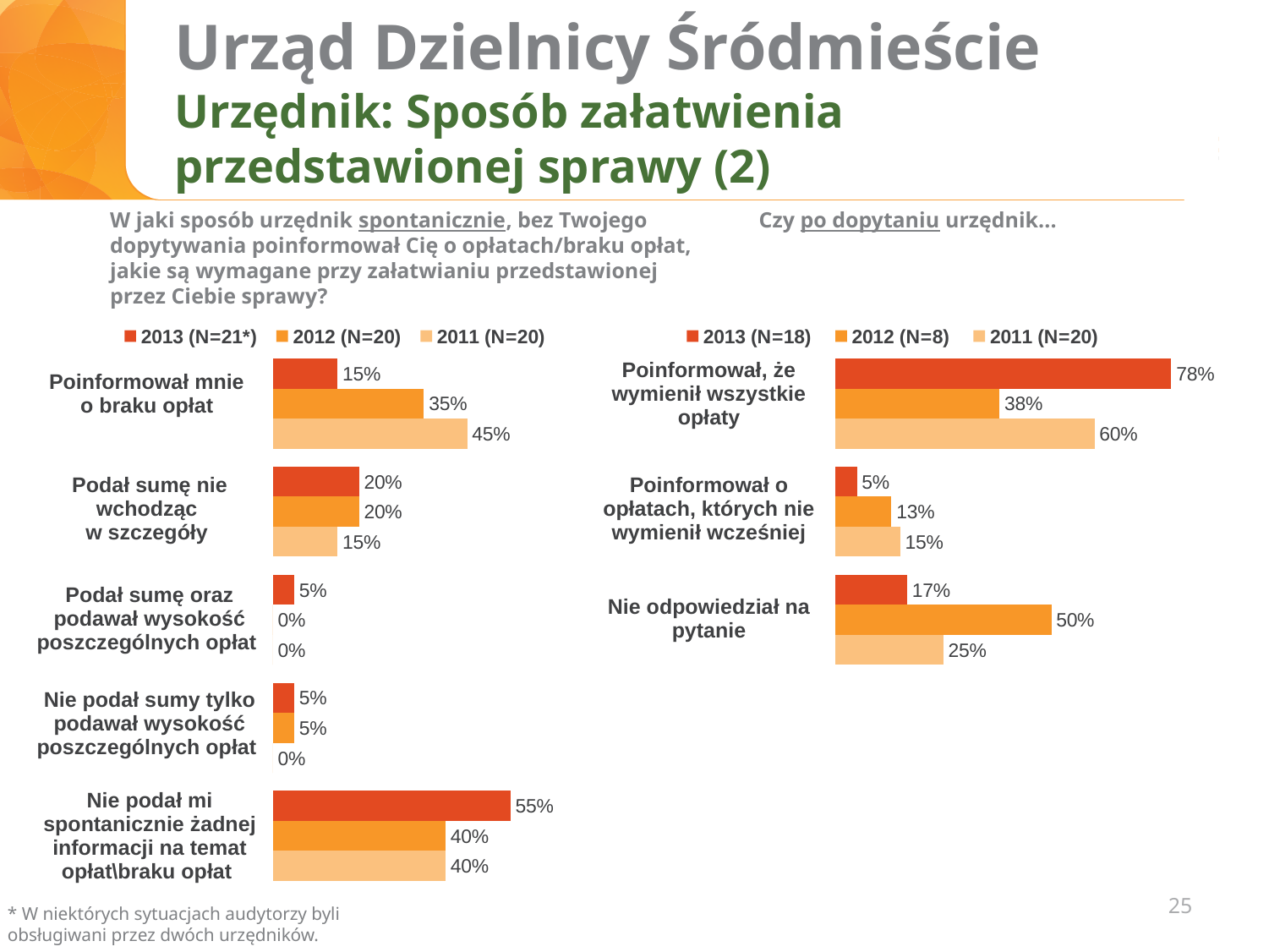
In the left chart, which category has the highest 2013 value? Nie podał mi spontanicznie żadnej informacji na temat opłat\braku opłat In the right chart, which category has the lowest 2013 value? Poinformował o opłatach, których nie wymienił wcześniej In the right chart, what is the 2013 value for "Poinformował, że wymienił wszystkie opłaty"? 78% In the left chart, what is the 2013 value for "Nie podał mi spontanicznie żadnej informacji na temat opłat\braku opłat"? 55% How many categories does the left chart show? 5 In the right chart, which is larger for "Nie odpowiedział na pytanie": the 2012 value or the 2011 value? 2012 In the left chart, what is the difference between the 2011 and 2013 values for "Poinformował mnie o braku opłat"? 30% In the right chart, what is the difference between the 2013 and 2012 values for "Poinformował, że wymienił wszystkie opłaty"? 40% How many series does the legend of the right chart list? 3 In the left chart, what is the 2011 value for "Poinformował mnie o braku opłat"? 45% In the right chart, what is the 2012 value for "Nie odpowiedział na pytanie"? 50% What type of chart is the left chart? Bar chart